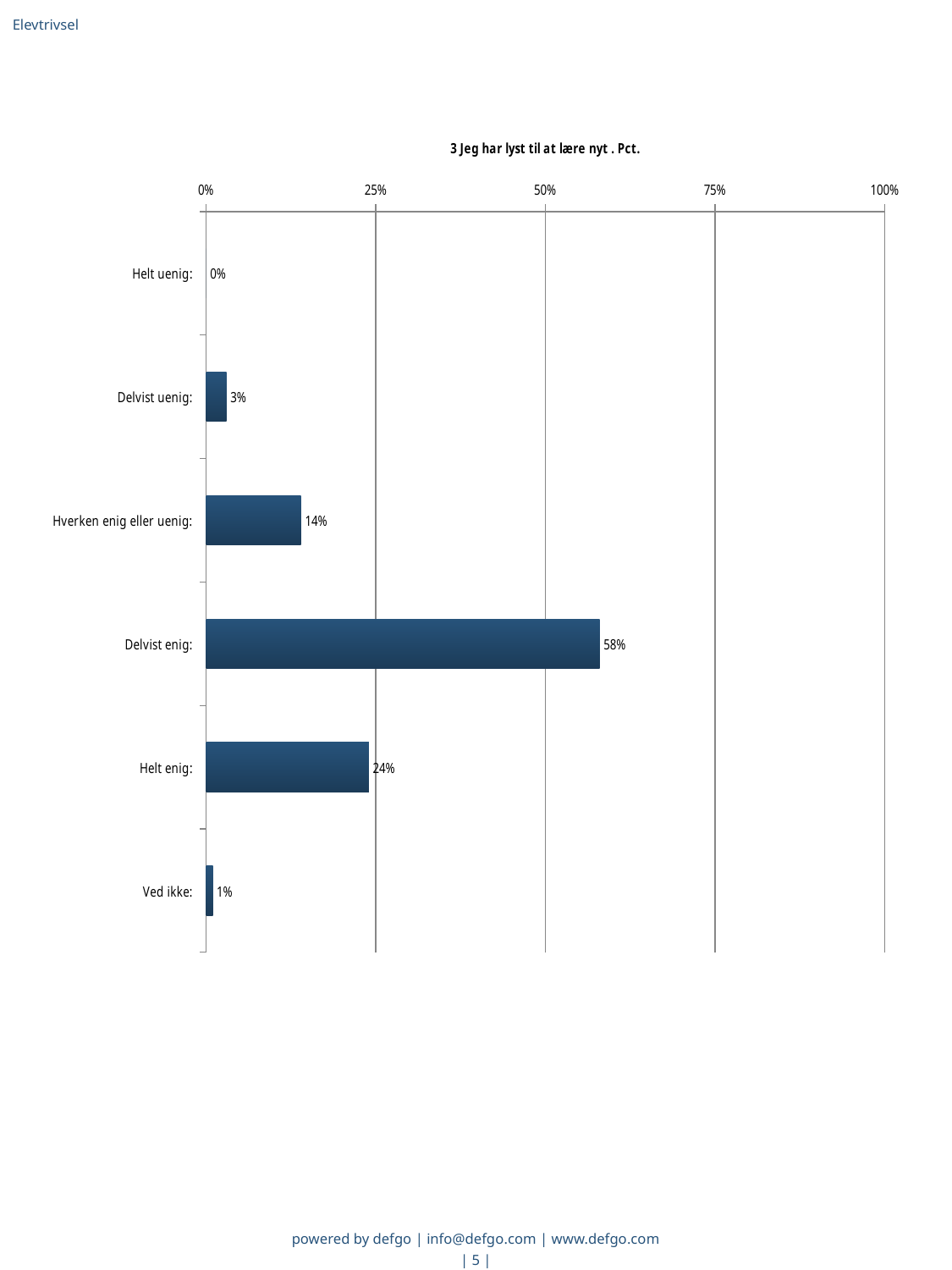
Which is larger, the value for Hverken enig eller uenig or the value for Delvist uenig? Hverken enig eller uenig Which category has the lowest value? Helt uenig How many categories are shown in the chart? 6 What kind of chart is shown on the slide? bar chart What is the difference between the values for Delvist enig and Helt enig? 34% Is the value for Delvist enig greater or less than 50%? greater What is the value for Helt enig? 24% What is the value for Delvist enig? 58% What is the value for Hverken enig eller uenig? 14% Which category has the highest value? Delvist enig What is the value for Ved ikke? 1% What is the title of the chart? 3 Jeg har lyst til at lære nyt . Pct.